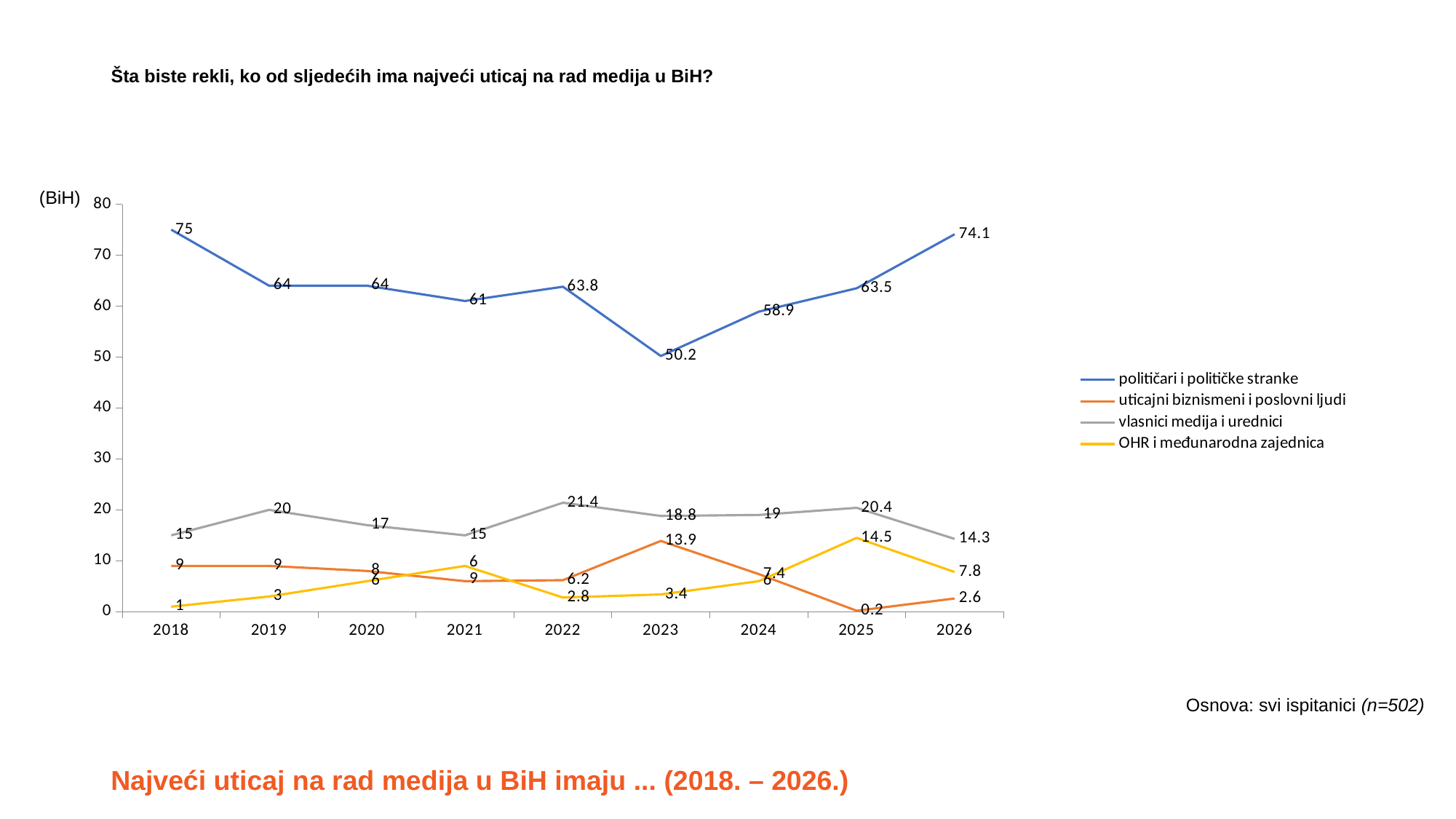
What value does the 'vlasnici medija i urednici' series have in 2022? 21.4 What value does the 'političari i političke stranke' series have in 2023? 50.2 What value does the 'uticajni biznismeni i poslovni ljudi' series have in 2025? 0.2 How many series does the legend list? 4 What type of chart is shown on the slide? line chart What value does the 'OHR i međunarodna zajednica' series have in 2025? 14.5 In which year is the 'političari i političke stranke' series at its lowest? 2023 By how much did the 'političari i političke stranke' value increase from 2025 to 2026? 10.6 How many years are shown on the x axis of the chart? 9 In which year does the 'vlasnici medija i urednici' series reach its highest value? 2022 What value does the 'političari i političke stranke' series have in 2018? 75 In 2023, which is larger: 'uticajni biznismeni i poslovni ljudi' or 'OHR i međunarodna zajednica'? uticajni biznismeni i poslovni ljudi